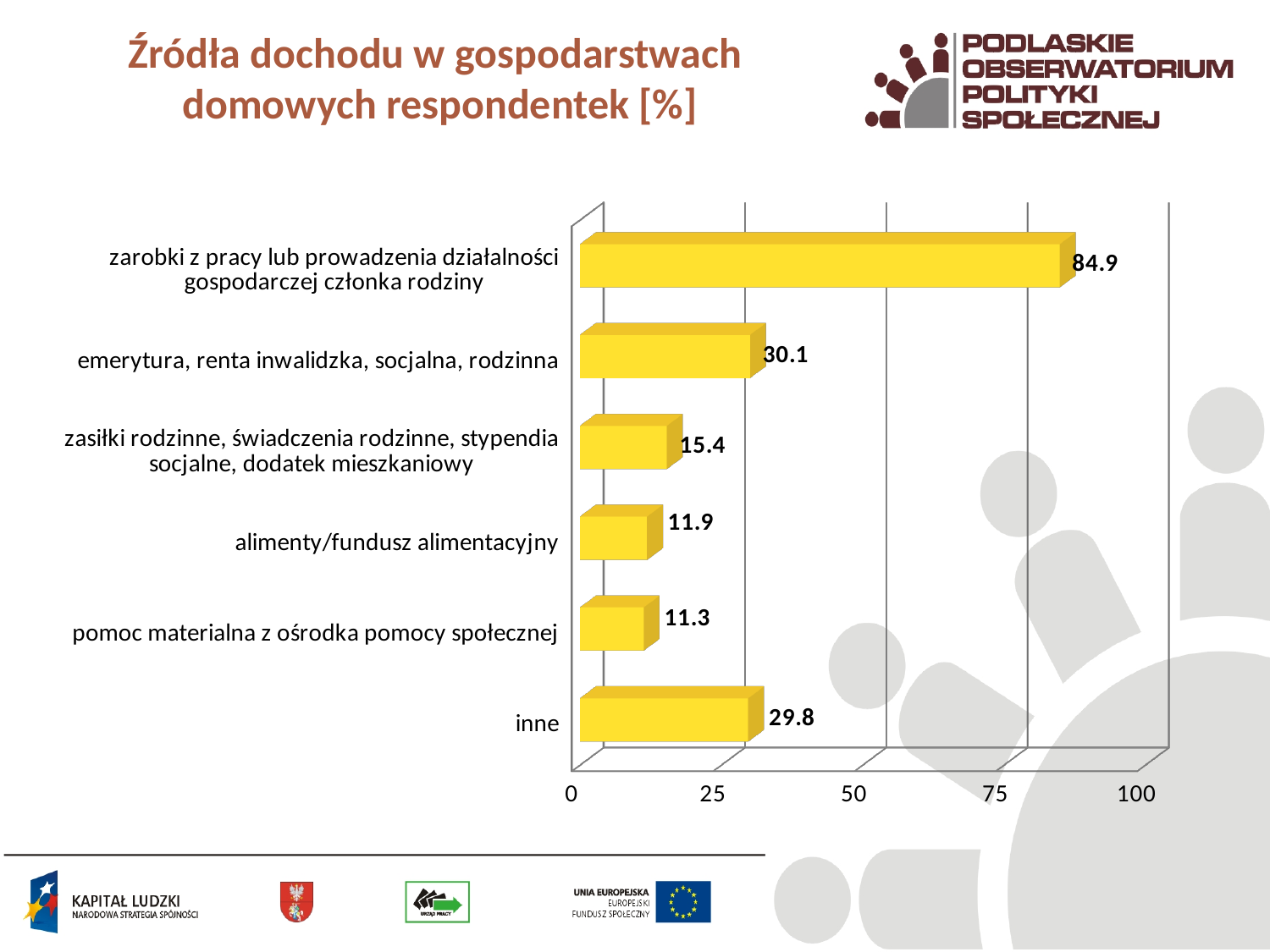
Which category has the lowest value? pomoc materialna z ośrodka pomocy społecznej What is the title of the chart on the slide? Źródła dochodu w gospodarstwach domowych respondentek [%] What kind of chart is shown on the slide? bar chart What is the value for 'emerytura, renta inwalidzka, socjalna, rodzinna'? 30.1 Which is larger: the value for 'zasiłki rodzinne, świadczenia rodzinne, stypendia socjalne, dodatek mieszkaniowy' or for 'alimenty/fundusz alimentacyjny'? zasiłki rodzinne, świadczenia rodzinne, stypendia socjalne, dodatek mieszkaniowy What is the difference between the values for 'emerytura, renta inwalidzka, socjalna, rodzinna' and 'inne'? 0.3 Is the value for 'emerytura, renta inwalidzka, socjalna, rodzinna' greater or less than 25? greater What is the value for 'zarobki z pracy lub prowadzenia działalności gospodarczej członka rodziny'? 84.9 How many categories are shown in the chart? 6 What is the value for 'inne'? 29.8 Which category has the highest value? zarobki z pracy lub prowadzenia działalności gospodarczej członka rodziny What is the value for 'alimenty/fundusz alimentacyjny'? 11.9